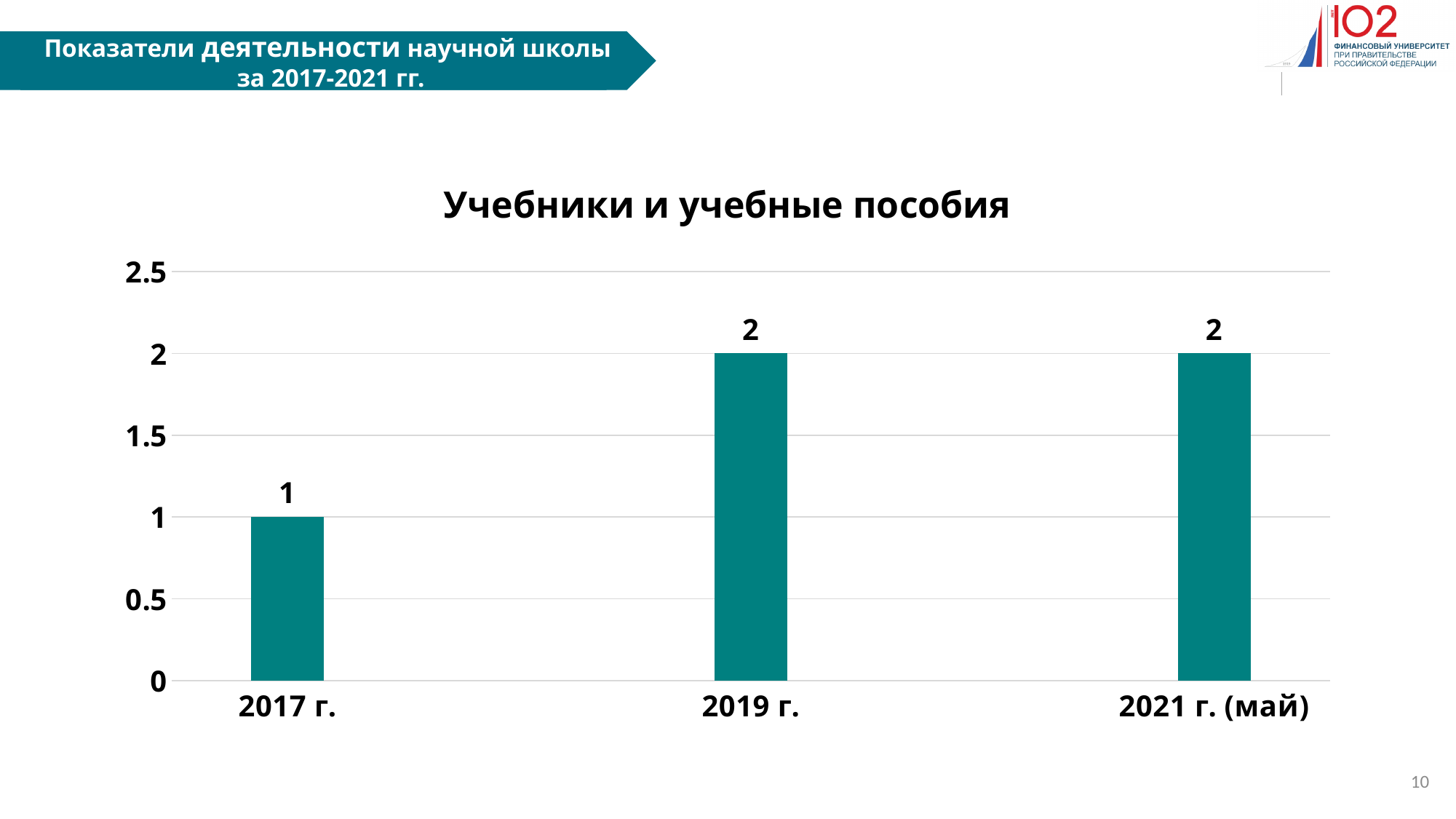
What is the difference between the values for 2019 г. and 2017 г.? 1 Which category has the lowest value? 2017 г. How many categories are shown on the x axis? 3 What is the value for 2019 г.? 2 Is the value for 2019 г. greater or less than 1.5? greater Which is larger, the value for 2017 г. or the value for 2021 г. (май)? 2021 г. (май) What kind of chart is this? bar chart Do the values rise or fall from 2017 г. to 2019 г.? rise What is the title of the chart? Учебники и учебные пособия What is the value for 2021 г. (май)? 2 What is the value for 2017 г.? 1 Is the value for 2017 г. greater or less than 1.5? less